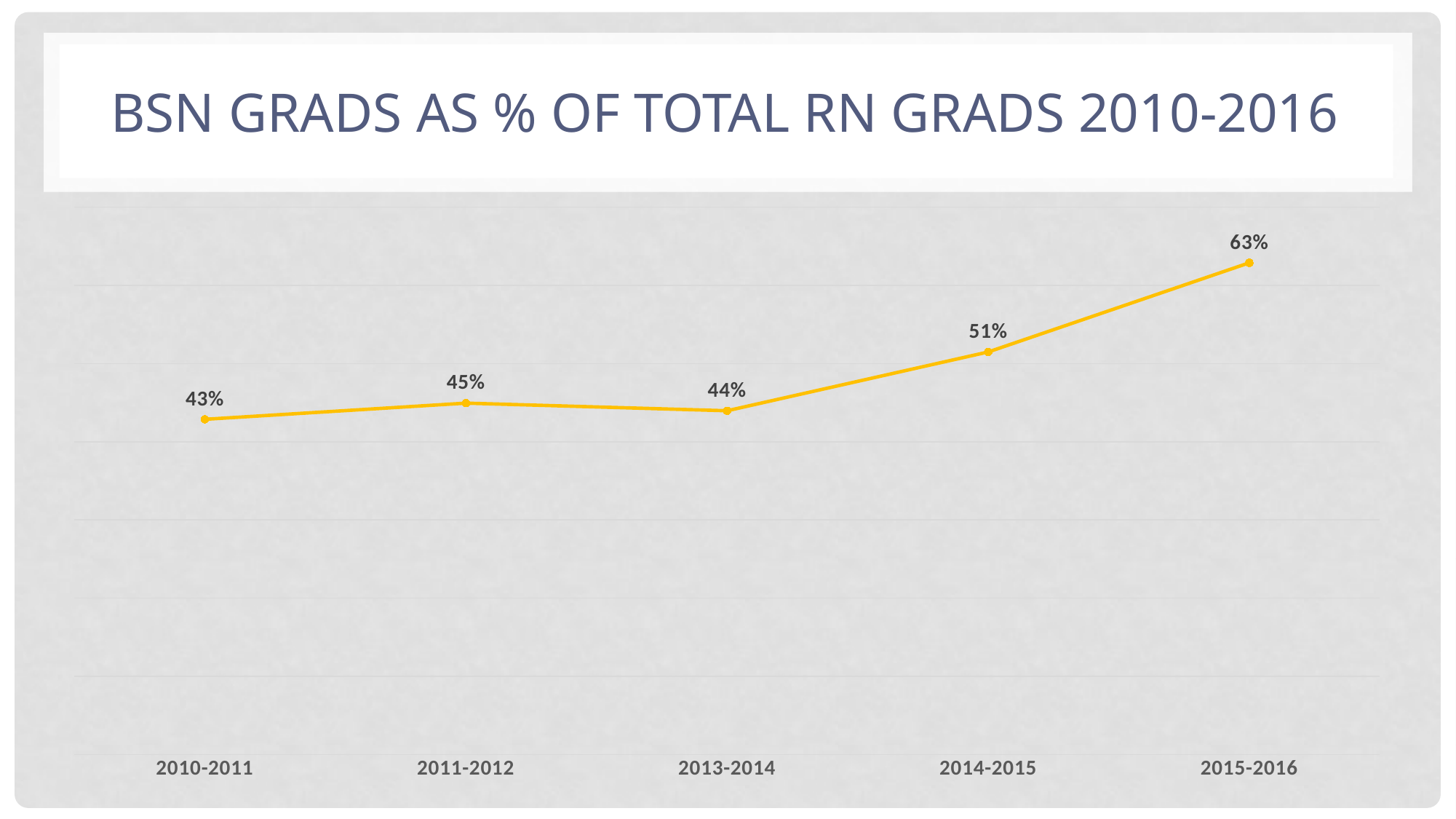
What is the title of the chart? BSN Grads as % of Total RN Grads 2010-2016 What is the value for 2010-2011? 43% What is the difference between the values for 2015-2016 and 2014-2015? 12% Which period has the highest value? 2015-2016 Do the values generally rise or fall from 2013-2014 to 2015-2016? rise Which is larger, the value for 2011-2012 or the value for 2013-2014? 2011-2012 Which period has the lowest value? 2010-2011 What is the value for 2013-2014? 44% How many data points are plotted on the chart? 5 What is the value for 2014-2015? 51% What kind of chart is shown on the slide? line chart What is the value for 2015-2016? 63%